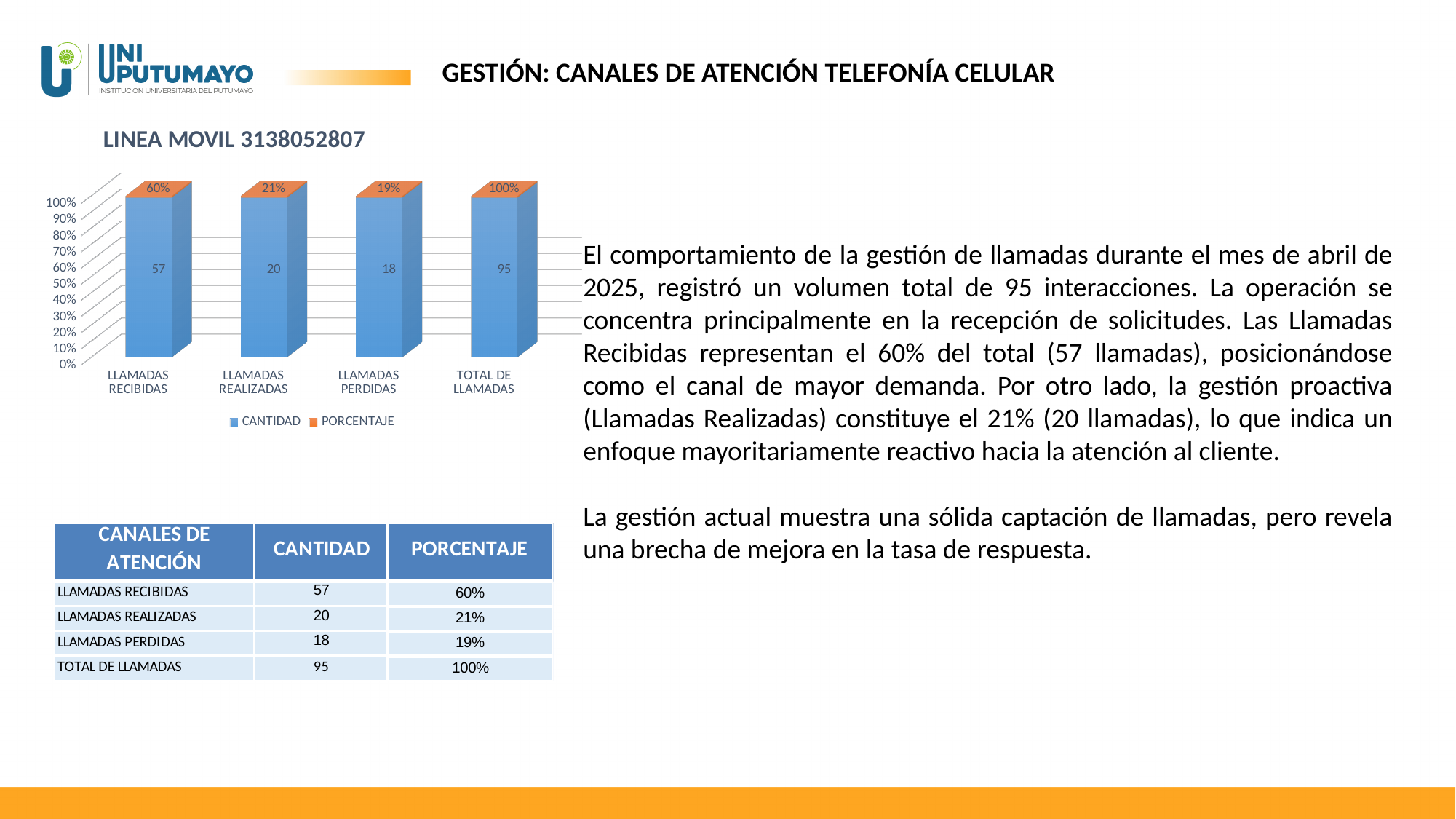
How many series does the chart legend list? 2 Which category has the lowest CANTIDAD value in the chart? LLAMADAS PERDIDAS What kind of chart is shown on the slide? Bar chart What is the CANTIDAD value for LLAMADAS RECIBIDAS in the chart? 57 What is the PORCENTAJE value for TOTAL DE LLAMADAS in the chart? 100% Which category has the highest CANTIDAD value in the chart? TOTAL DE LLAMADAS What is the CANTIDAD value for LLAMADAS PERDIDAS in the chart? 18 What is the PORCENTAJE value for LLAMADAS REALIZADAS in the chart? 21% How many categories are shown on the x axis of the chart? 4 What is the difference between the CANTIDAD values for LLAMADAS RECIBIDAS and LLAMADAS REALIZADAS? 37 What is the title of the chart? LINEA MOVIL 3138052807 Which is larger, the CANTIDAD value for LLAMADAS REALIZADAS or for LLAMADAS PERDIDAS? LLAMADAS REALIZADAS